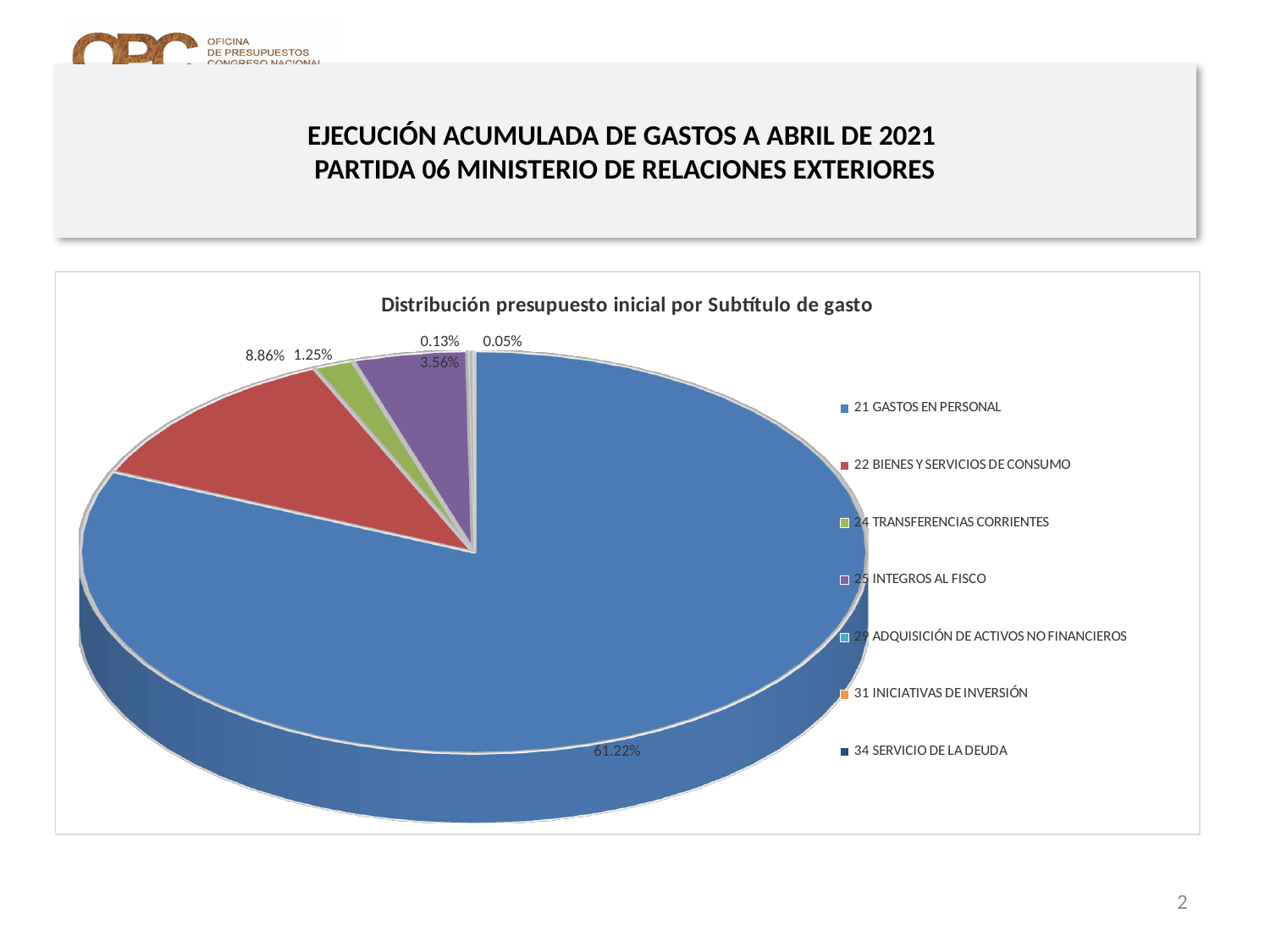
What is the smallest percentage label printed on the chart? 0.05% What is the title of the chart? Distribución presupuesto inicial por Subtítulo de gasto What percentage is shown for 22 BIENES Y SERVICIOS DE CONSUMO? 8.86% What is the difference in percentage points between 21 GASTOS EN PERSONAL and 22 BIENES Y SERVICIOS DE CONSUMO? 52.36 percentage points Which category has the largest share of the pie? 21 GASTOS EN PERSONAL What kind of chart is shown on the slide? Pie chart What is the difference in percentage points between 22 BIENES Y SERVICIOS DE CONSUMO and 25 INTEGROS AL FISCO? 5.30 percentage points How many categories does the chart legend list? 7 What percentage is shown for 24 TRANSFERENCIAS CORRIENTES? 1.25% What percentage is shown for 21 GASTOS EN PERSONAL? 61.22% Which has a larger share: 22 BIENES Y SERVICIOS DE CONSUMO or 25 INTEGROS AL FISCO? 22 BIENES Y SERVICIOS DE CONSUMO What percentage is shown for 25 INTEGROS AL FISCO? 3.56%